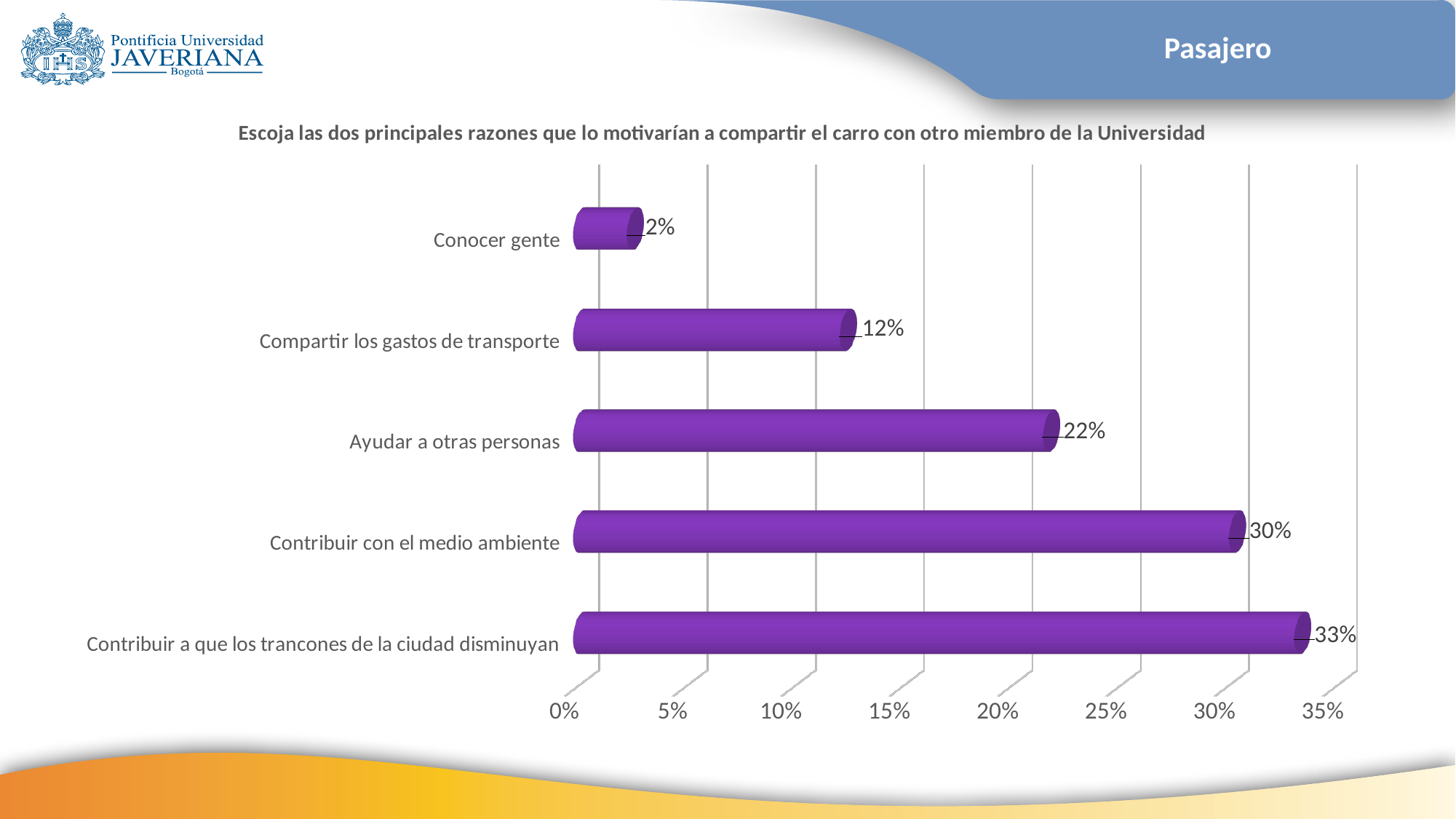
What is the difference between the values for "Ayudar a otras personas" and "Compartir los gastos de transporte"? 10% What kind of chart is shown on the slide? Bar chart What is the value for "Compartir los gastos de transporte"? 12% Which category has the lowest value? Conocer gente Is the value for "Ayudar a otras personas" greater or less than 20%? greater What is the title of the chart? Escoja las dos principales razones que lo motivarían a compartir el carro con otro miembro de la Universidad What is the value for "Contribuir con el medio ambiente"? 30% Which category has the highest value? Contribuir a que los trancones de la ciudad disminuyan What is the value for "Conocer gente"? 2% What is the difference between the values for "Contribuir a que los trancones de la ciudad disminuyan" and "Contribuir con el medio ambiente"? 3% Which is larger, the value for "Ayudar a otras personas" or the value for "Compartir los gastos de transporte"? Ayudar a otras personas How many categories are shown in the chart? 5